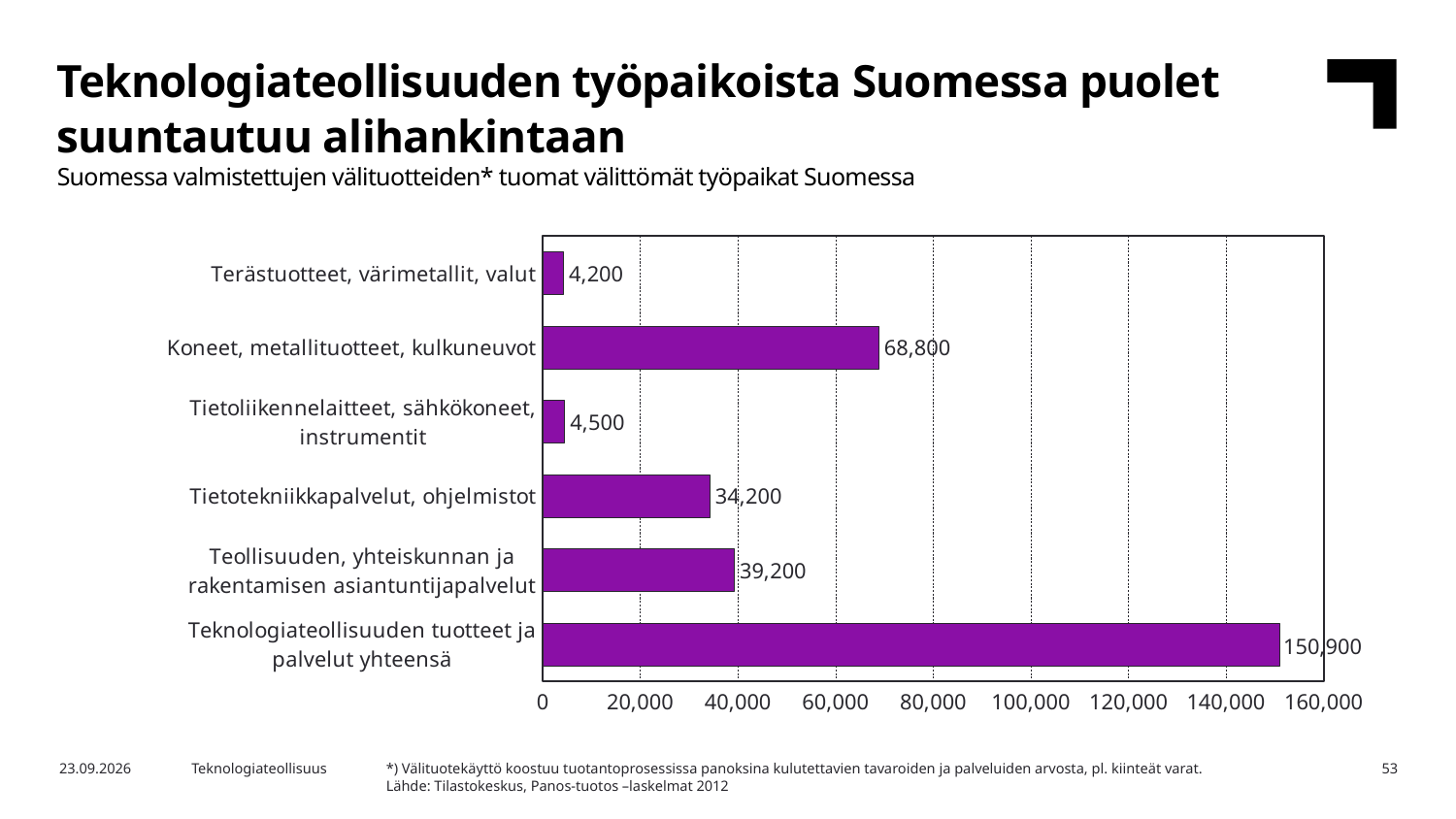
What is the value for Tietotekniikkapalvelut, ohjelmistot? 34,200 Which is larger: Teollisuuden, yhteiskunnan ja rakentamisen asiantuntijapalvelut or Tietotekniikkapalvelut, ohjelmistot? Teollisuuden, yhteiskunnan ja rakentamisen asiantuntijapalvelut What is the value for Tietoliikennelaitteet, sähkökoneet, instrumentit? 4,500 How many categories are shown in the chart? 6 Which category has the highest value? Teknologiateollisuuden tuotteet ja palvelut yhteensä What is the value for Koneet, metallituotteet, kulkuneuvot? 68,800 Is the value for Koneet, metallituotteet, kulkuneuvot greater or less than 60,000? greater What is the difference between Teollisuuden, yhteiskunnan ja rakentamisen asiantuntijapalvelut and Tietotekniikkapalvelut, ohjelmistot? 5,000 What kind of chart is shown on the slide? bar chart Which category has the lowest value? Terästuotteet, värimetallit, valut What is the difference between Koneet, metallituotteet, kulkuneuvot and Tietotekniikkapalvelut, ohjelmistot? 34,600 What is the value for Teknologiateollisuuden tuotteet ja palvelut yhteensä? 150,900